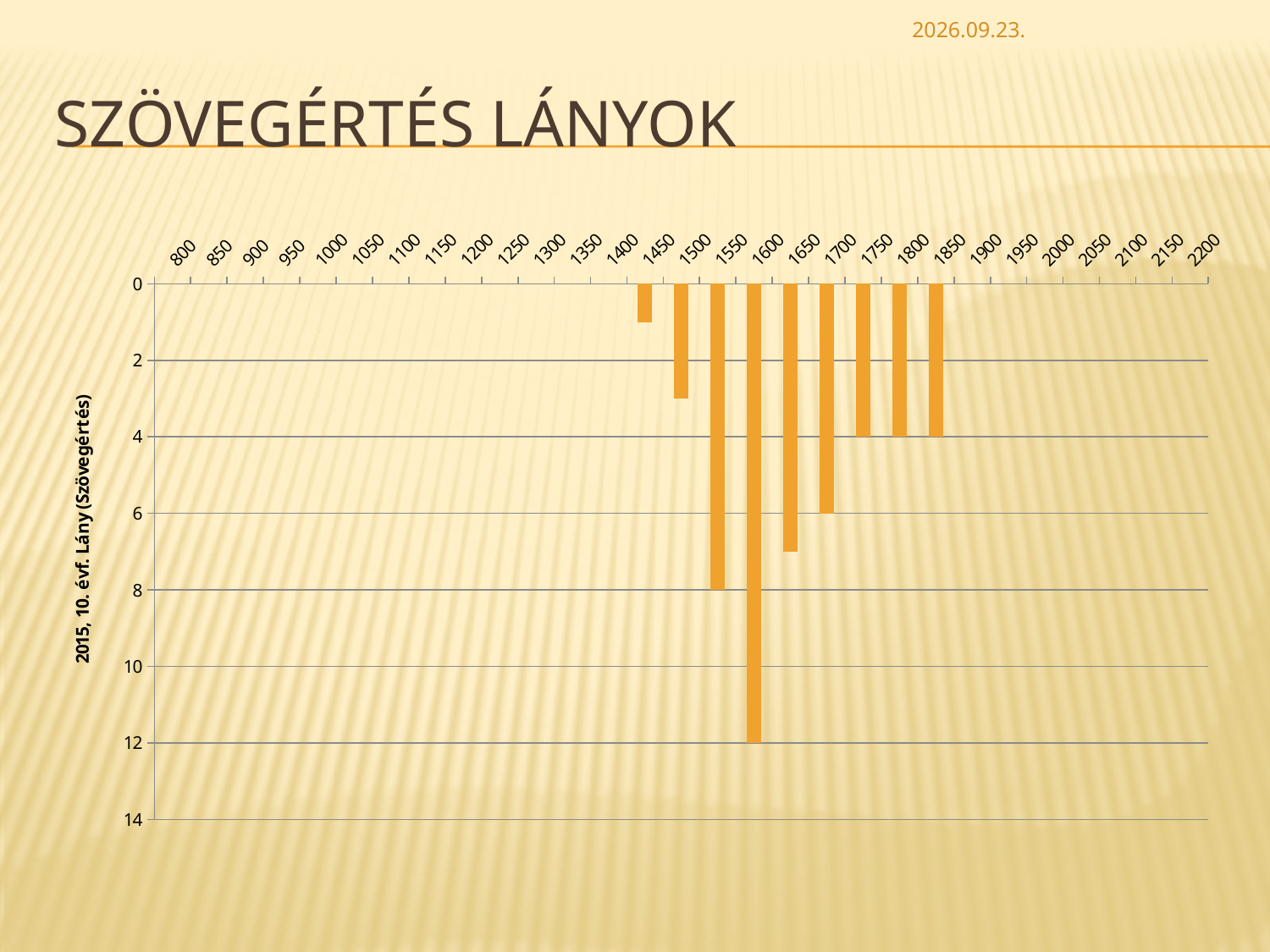
What is the title of the vertical axis? 2015, 10. évf. Lány (Szövegértés) How many categories have a bar plotted? 9 Which category with a bar has the lowest value? 1450 What is the value for the 1550 category? 8 What is the value for the 1700 category? 6 Is the value for 1500 greater or less than 2? greater Which is larger, the value for 1650 or the value for 1700? 1650 What is the value for the 1750 category? 4 What is the value for the 1600 category? 12 Which category has the highest value? 1600 What kind of chart is shown on the slide? bar chart What is the difference between the values for 1600 and 1550? 4